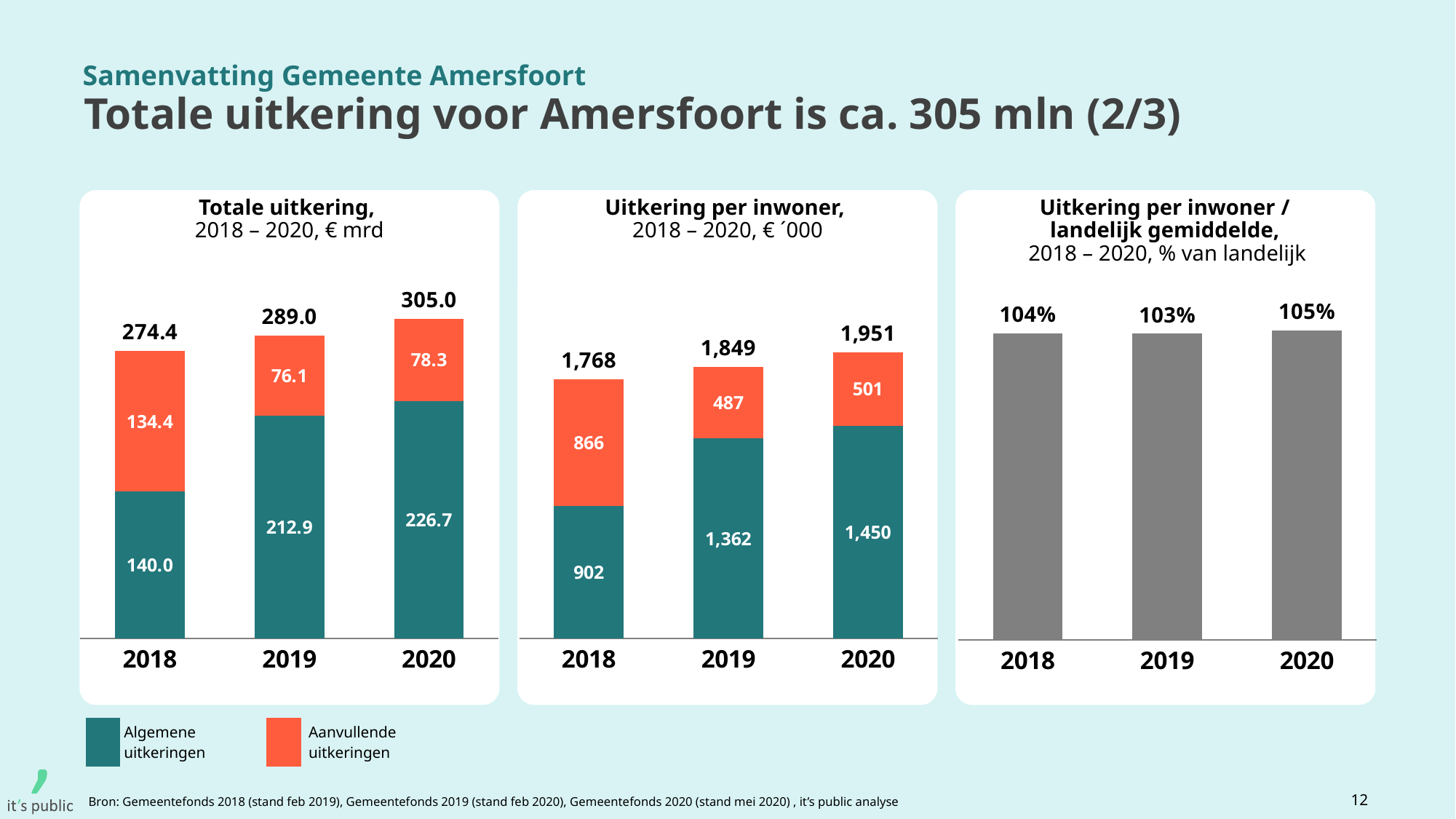
In the 'Uitkering per inwoner / landelijk gemiddelde' chart, which year has the lowest value? 2019 How many series does the legend at the bottom of the slide list? 2 In the 'Uitkering per inwoner' chart, what is the total for 2018? 1,768 In the 'Uitkering per inwoner' chart, is Aanvullende uitkeringen larger in 2018 or in 2020? 2018 In the 'Uitkering per inwoner' chart, which year has the highest total? 2020 In the 'Totale uitkering' chart, what is the value of Algemene uitkeringen in 2018? 140.0 In the 'Uitkering per inwoner' chart, what is the value of Algemene uitkeringen in 2019? 1,362 In the 'Totale uitkering' chart, what is the total for 2020? 305.0 In the 'Totale uitkering' chart, what is the value of Aanvullende uitkeringen in 2019? 76.1 In the 'Totale uitkering' chart, what is the difference between the 2020 total and the 2018 total? 30.6 In the 'Uitkering per inwoner / landelijk gemiddelde' chart, what is the value for 2019? 103% What kind of chart is the 'Totale uitkering' chart? Stacked bar chart